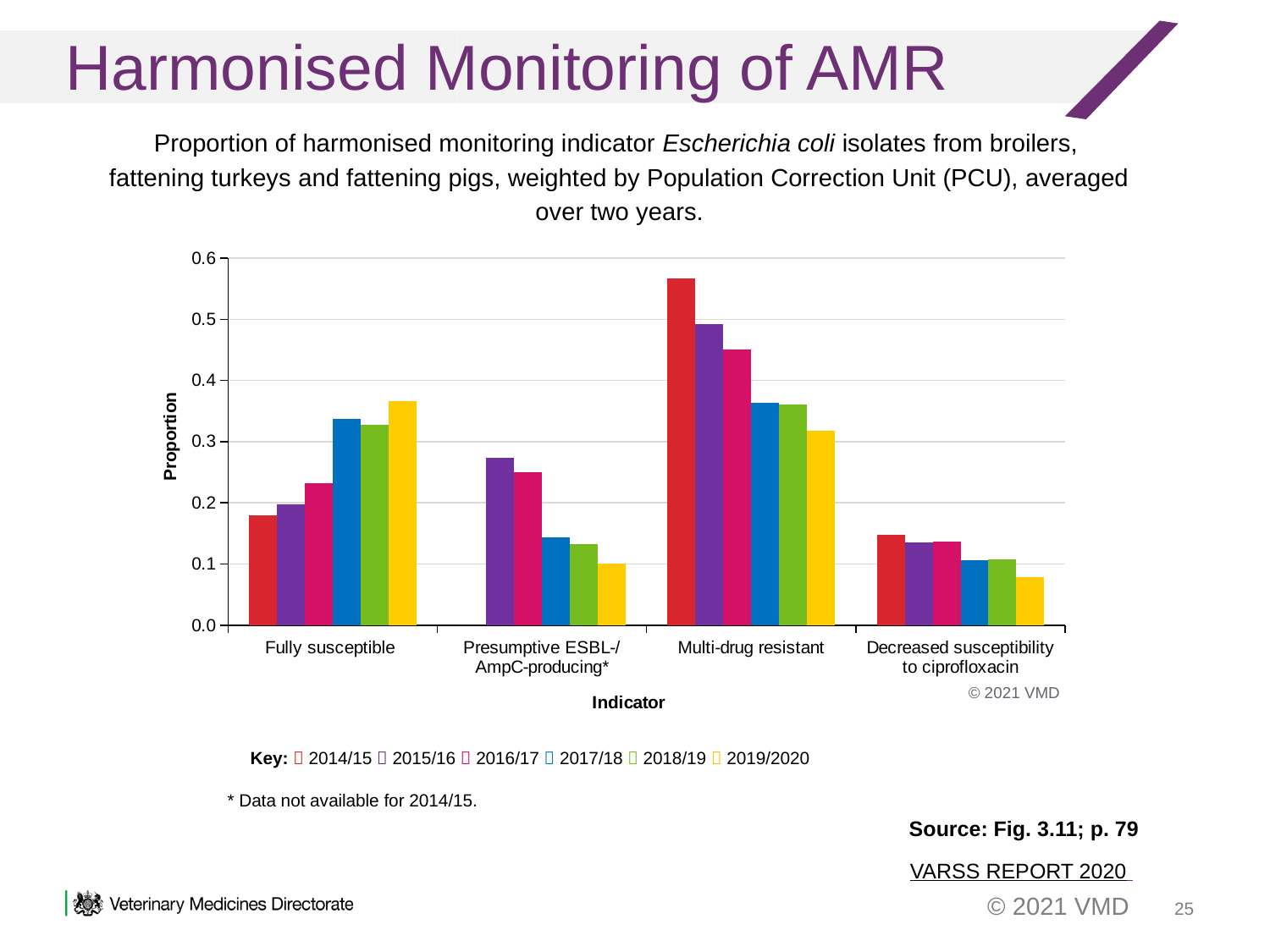
Is the Fully susceptible proportion for 2019/2020 greater or less than 0.3? greater Is the Multi-drug resistant proportion for 2014/15 greater or less than 0.5? greater According to the footnote, for which year is data not available for the Presumptive ESBL-/AmpC-producing indicator? 2014/15 What kind of chart is shown on the slide? Bar chart How many years (series) does the key list? 6 Is the Presumptive ESBL-/AmpC-producing proportion for 2019/2020 greater or less than 0.2? less How many indicator categories are shown along the x axis? 4 Does the Multi-drug resistant proportion rise or fall from 2014/15 to 2019/2020? Fall Which year has the lowest bar for Decreased susceptibility to ciprofloxacin? 2019/2020 Which indicator has the tallest bar on the chart? Multi-drug resistant For Multi-drug resistant, which is larger: the 2014/15 bar or the 2019/2020 bar? 2014/15